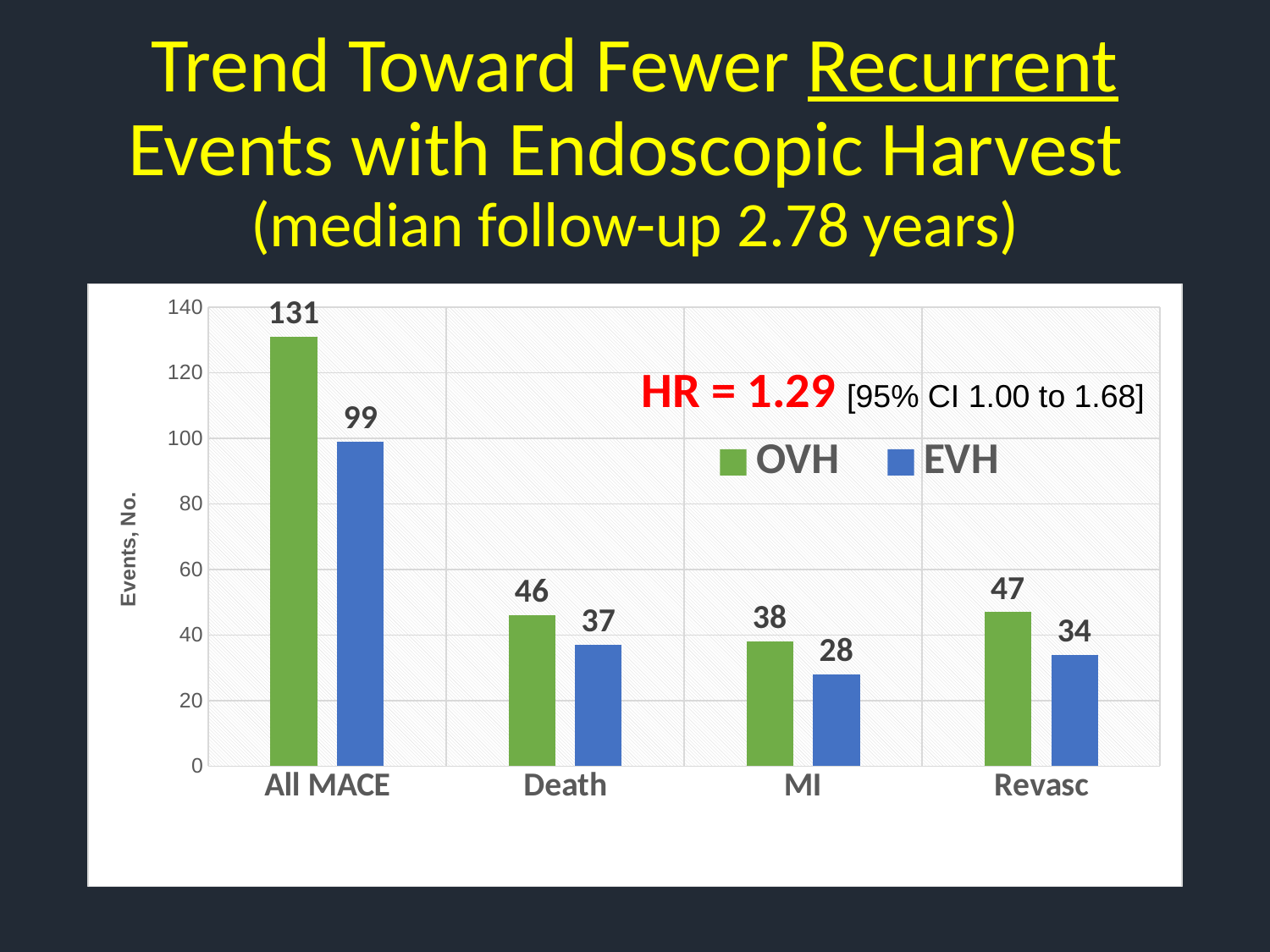
What is the OVH value for All MACE? 131 What is the difference between the OVH and EVH values for All MACE? 32 What is the EVH value for MI? 28 Which is larger for Revasc, the OVH value or the EVH value? OVH What is the OVH value for Revasc? 47 What is the label of the y axis? Events, No. Which category has the highest EVH value? All MACE How many series does the legend list? 2 What kind of chart is shown on the slide? Bar chart How many categories are shown on the x axis? 4 What is the EVH value for Death? 37 Which category has the lowest OVH value? MI